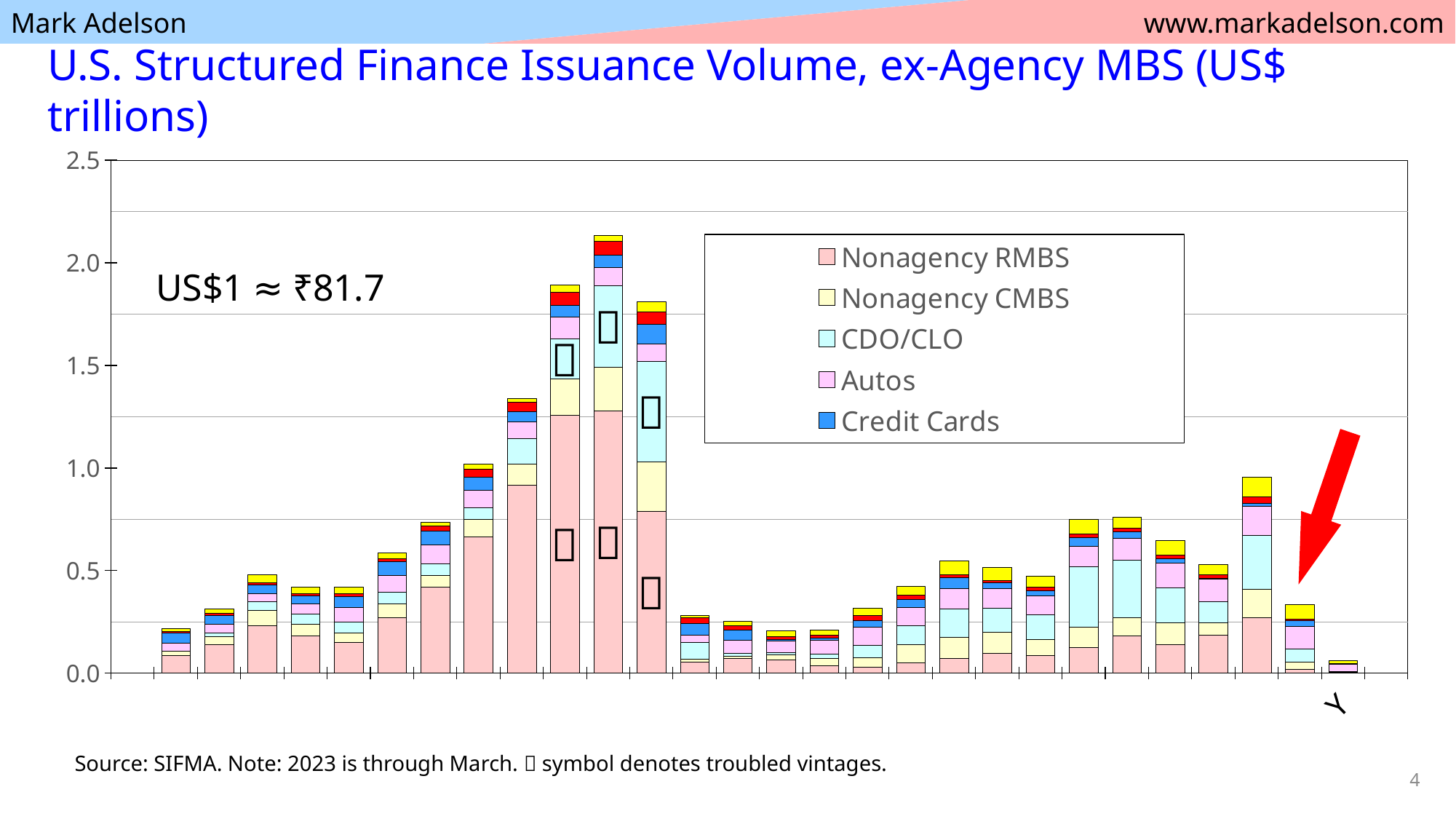
How many series does the legend list? 5 Which series is shown in blue in the legend? Credit Cards Is the total of the tallest bar greater or less than 2.0? greater How many bars are plotted in the chart? 28 Is the total of the last (rightmost) bar greater or less than 0.5? less Is the total of the first (leftmost) bar greater or less than 0.5? less What is the title of the chart? U.S. Structured Finance Issuance Volume, ex-Agency MBS (US$ trillions) What is the highest value shown on the y axis? 2.5 What kind of chart is shown on the slide? Stacked bar chart Do the bar totals rise or fall immediately after the tallest bar? Fall Which is larger, the tallest bar or the last bar on the right? The tallest bar